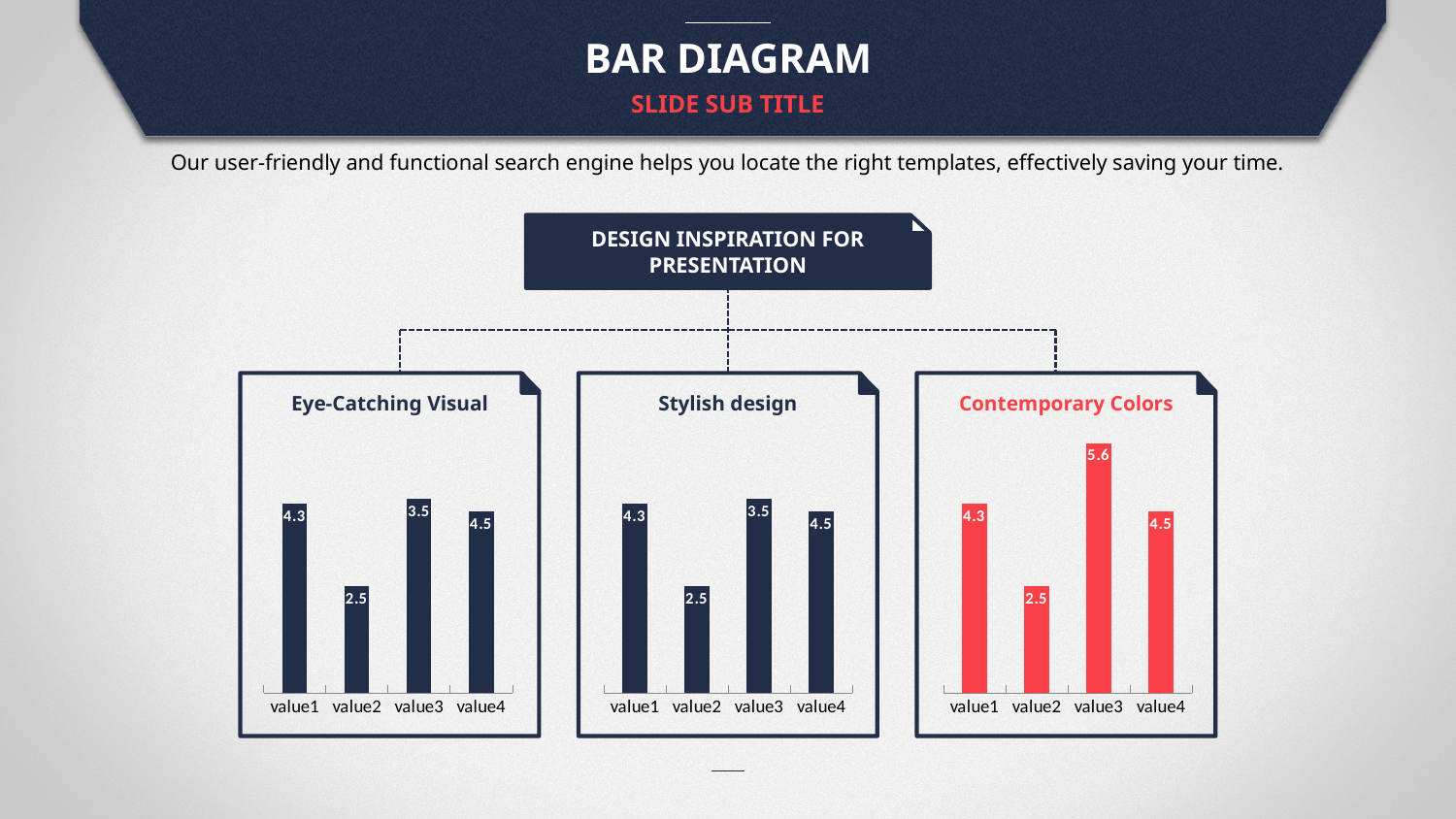
What type of chart is shown in the right chart (Contemporary Colors)? bar chart In the left chart (Eye-Catching Visual), what is the value for value1? 4.3 In the middle chart (Stylish design), what is the difference between value4 and value2? 2 In the left chart (Eye-Catching Visual), which category has the lowest value? value2 In the left chart (Eye-Catching Visual), which category has the highest value? value4 In the right chart (Contemporary Colors), which is larger, value1 or value4? value4 In the right chart (Contemporary Colors), what is the value for value3? 5.6 In the right chart (Contemporary Colors), which category has the highest value? value3 In the middle chart (Stylish design), how many categories are shown? 4 In the middle chart (Stylish design), what is the value for value3? 3.5 What colour are the bars in the right chart (Contemporary Colors)? red In the right chart (Contemporary Colors), what is the difference between value3 and value1? 1.3